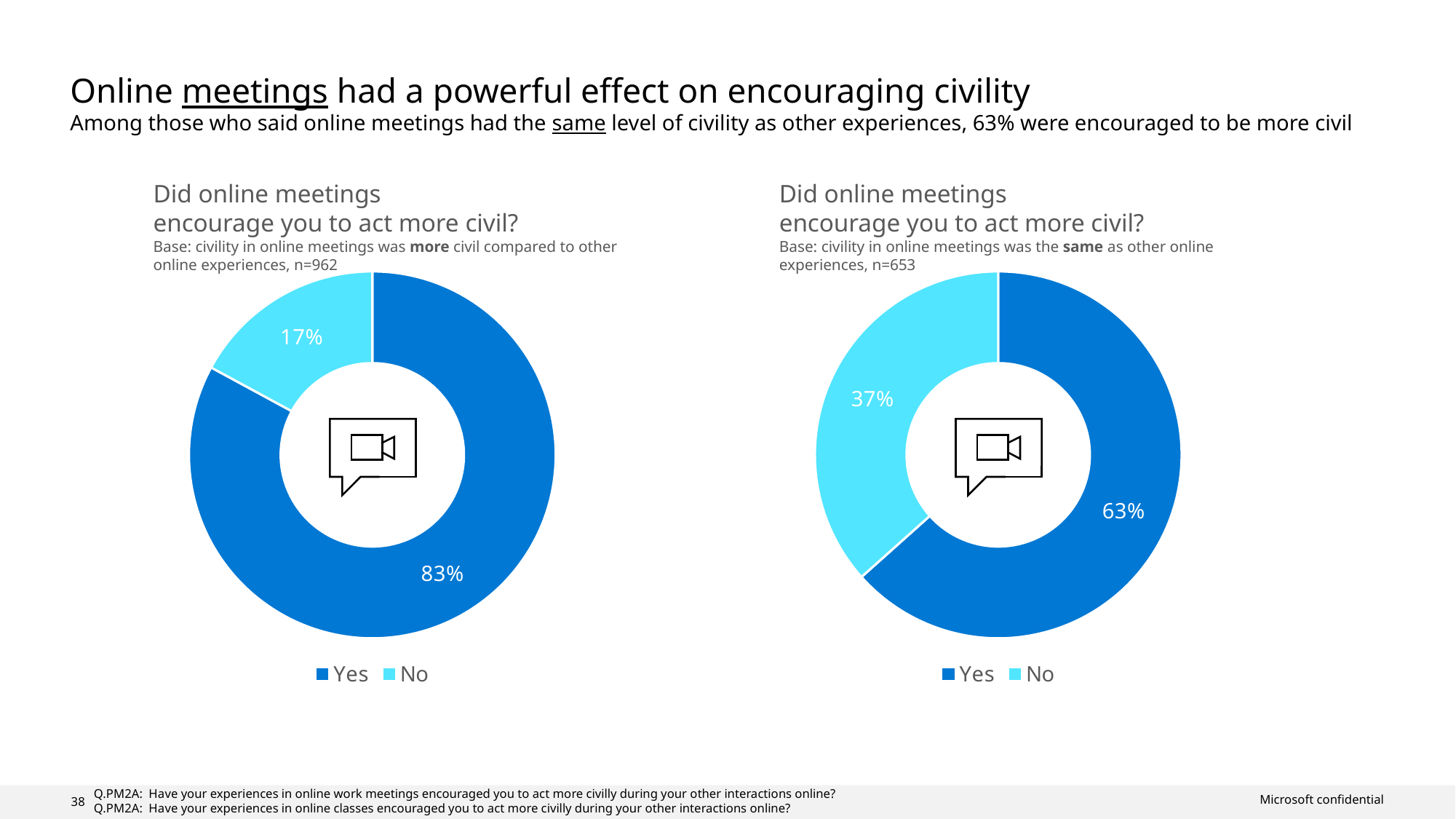
In the right chart, which response has the smaller share? No What type of chart is used on the left side of the slide? Doughnut chart Which colour represents the No response in the right chart? Light blue In the left chart (base: online meetings were more civil, n=962), what percentage answered No? 17% In the right chart, what is the difference in percentage points between the Yes and No shares? 26 In the left chart, which response has the larger share, Yes or No? Yes How many categories does the legend of the right chart list? 2 In the left chart (base: online meetings were more civil, n=962), what percentage answered Yes? 83% In the right chart (base: online meetings were the same as other online experiences, n=653), what percentage answered No? 37% In the right chart (base: online meetings were the same as other online experiences, n=653), what percentage answered Yes? 63% What is the base size (n) for the left chart? n=962 In the left chart, what is the difference in percentage points between the Yes and No shares? 66